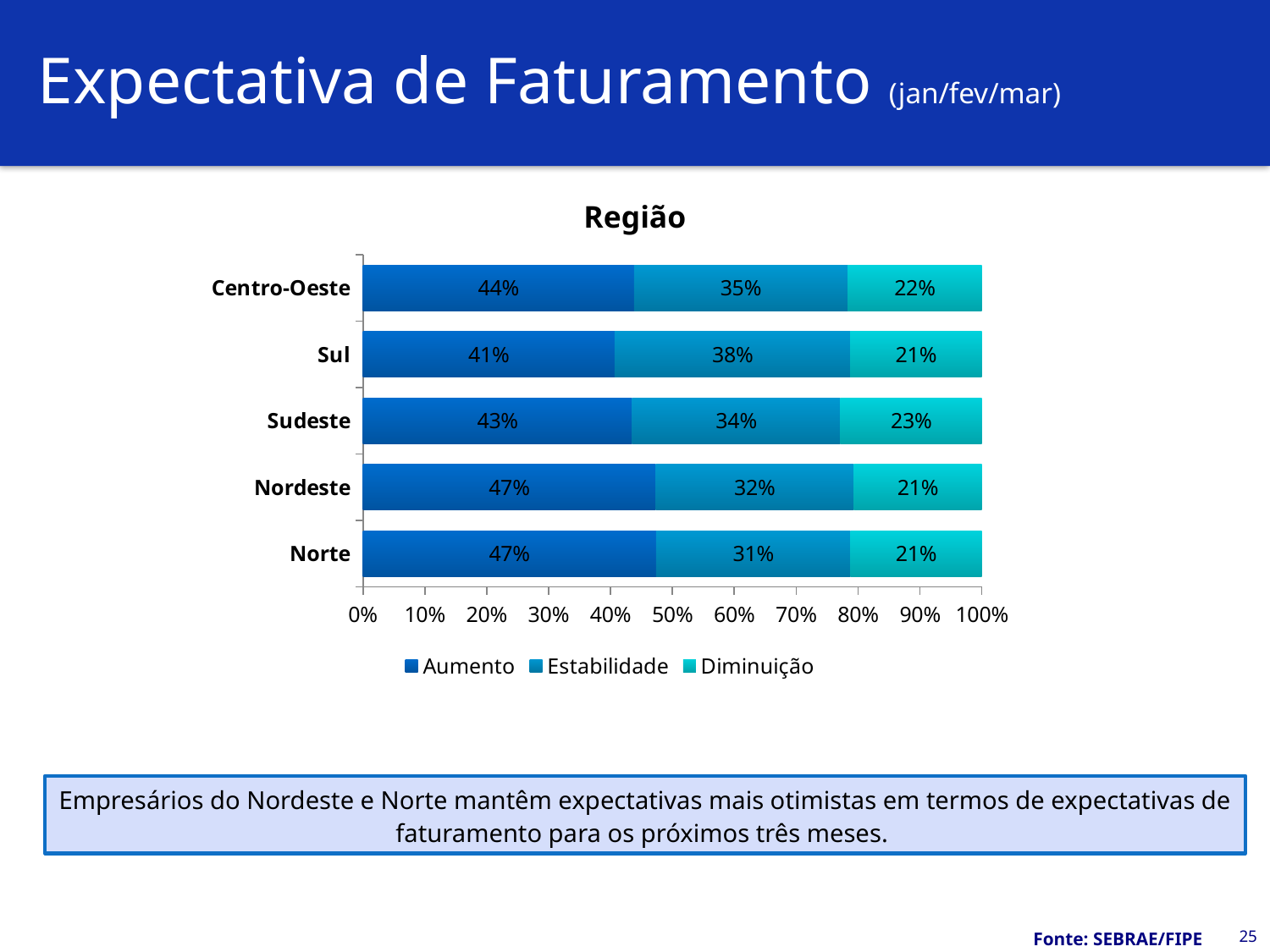
Which region has the highest Diminuição value? Sudeste How many series does the legend list? 3 What is the title of the chart? Região Which region has the highest Estabilidade value? Sul What kind of chart is shown on the slide? Stacked bar chart What is the Diminuição value for Nordeste? 21% Which is larger, the Aumento value for Centro-Oeste or the Aumento value for Sul? Centro-Oeste What is the Estabilidade value for Centro-Oeste? 35% How many regions are shown in the chart? 5 Which region has the lowest Aumento value? Sul What is the Aumento value for Sudeste? 43% What is the difference between the Estabilidade values for Sul and Norte? 7 percentage points